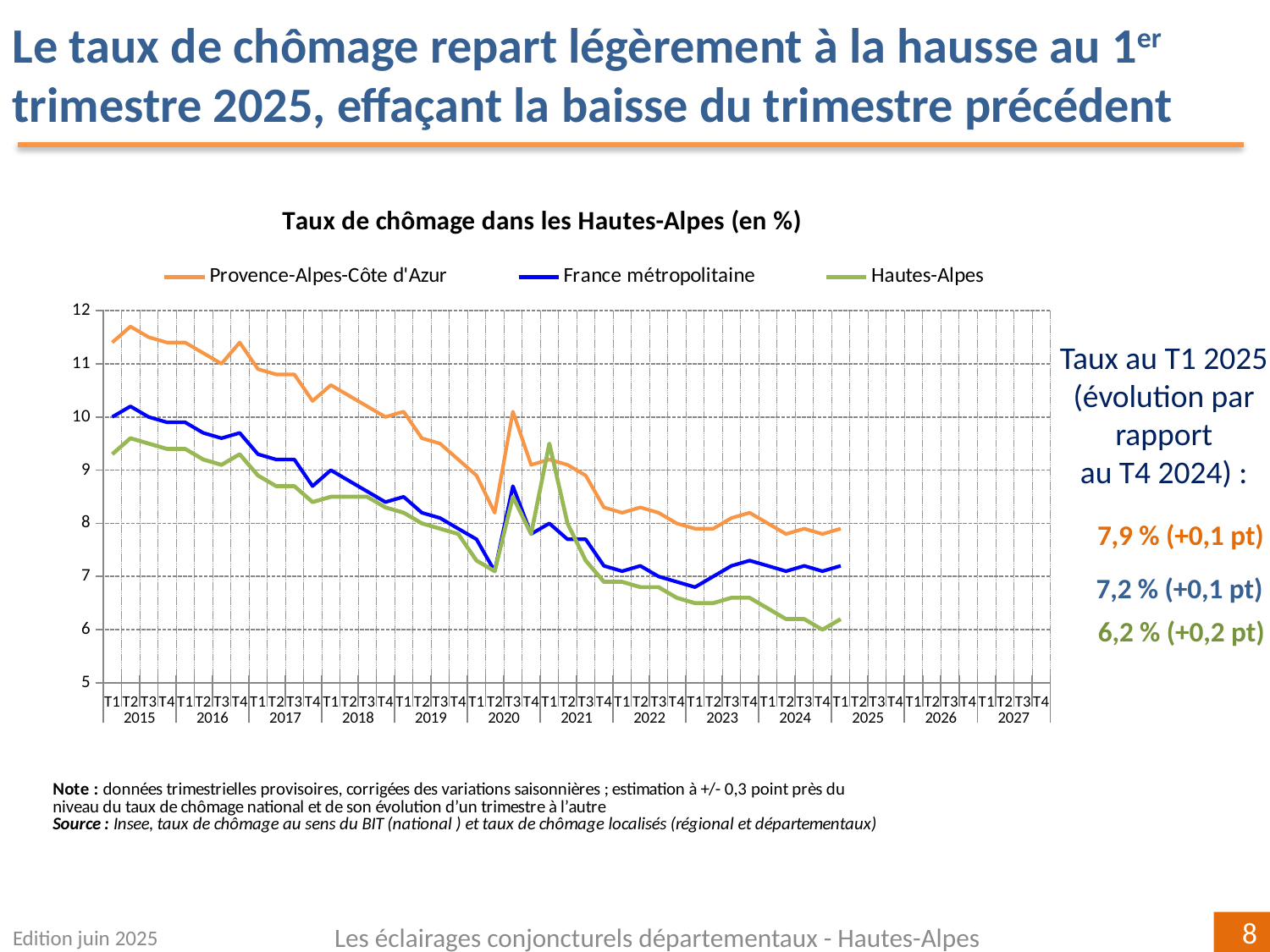
Which series has the highest value at T1 2025? Provence-Alpes-Côte d'Azur By how much did the Hautes-Alpes rate change between T4 2024 and T1 2025? +0,2 pt At T1 2025, which is higher: the rate for France métropolitaine or the rate for Hautes-Alpes? France métropolitaine What is the unemployment rate for Hautes-Alpes at T1 2025? 6,2 % Is the value for Provence-Alpes-Côte d'Azur at T1 2015 greater or less than 11? greater What is the difference between the Provence-Alpes-Côte d'Azur rate and the Hautes-Alpes rate at T1 2025? 1,7 points Is the value for Hautes-Alpes at T4 2024 greater or less than 7? less What is the unemployment rate for Provence-Alpes-Côte d'Azur at T1 2025? 7,9 % What is the title of the chart? Taux de chômage dans les Hautes-Alpes (en %) How many series does the legend of the chart list? 3 What kind of chart is shown on the slide? line chart What is the unemployment rate for France métropolitaine at T1 2025? 7,2 %